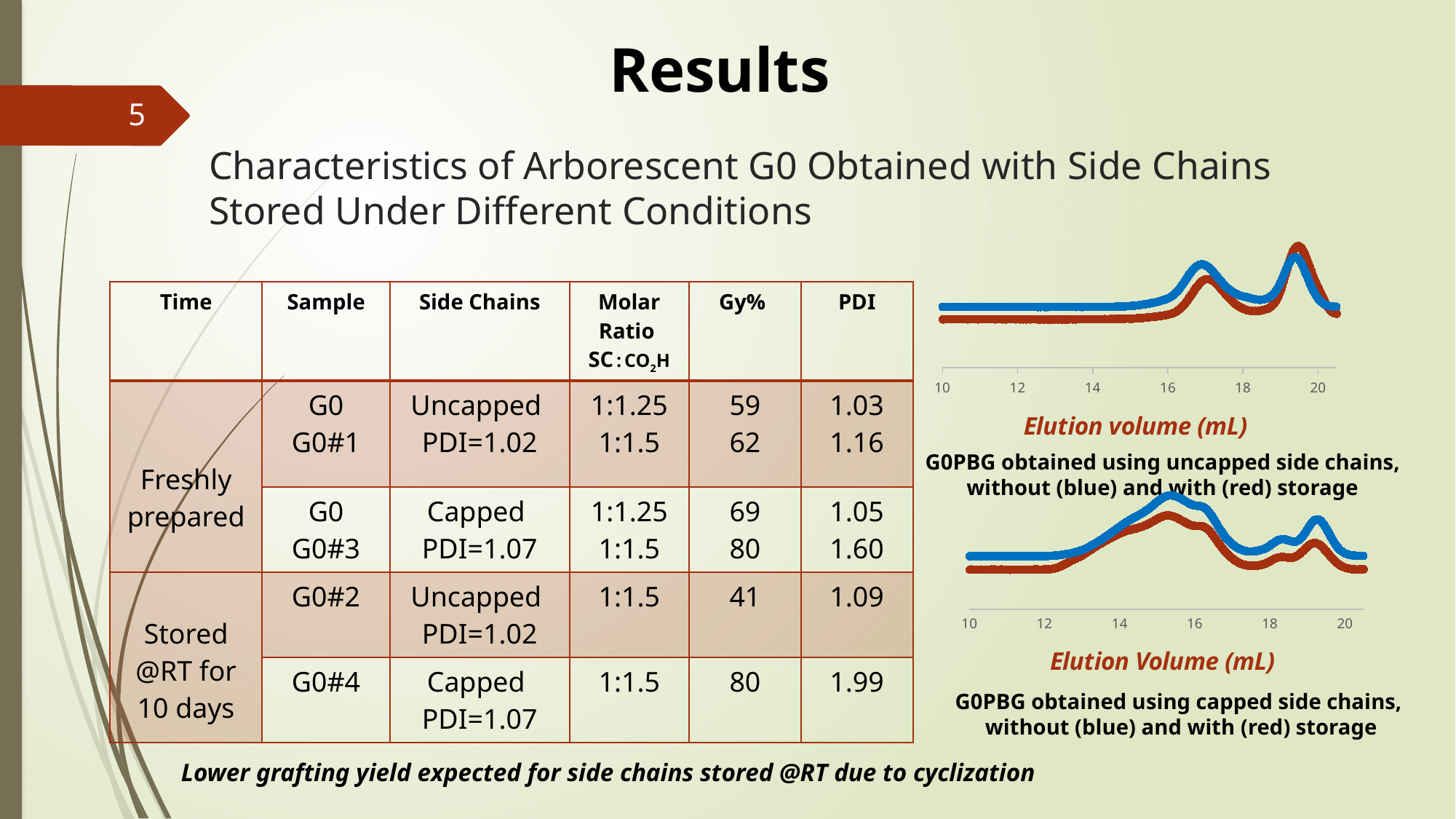
What kind of chart is the top chart on the right of the slide? line chart In the top chart, what is the x-axis label? Elution volume (mL) In the bottom chart, which colour represents the sample obtained with storage? red How many curves are plotted in the top chart (G0PBG obtained using uncapped side chains)? 2 In the top chart, is the elution volume of the tallest peak greater or less than 18 mL? greater What kind of chart is the bottom chart on the right of the slide? line chart In the bottom chart, what is the x-axis label? Elution Volume (mL) In the bottom chart, is the elution volume of the tallest peak greater or less than 16 mL? less In the top chart, is the elution volume of the first (left-hand) peak greater or less than 18 mL? less How many curves are plotted in the bottom chart (G0PBG obtained using capped side chains)? 2